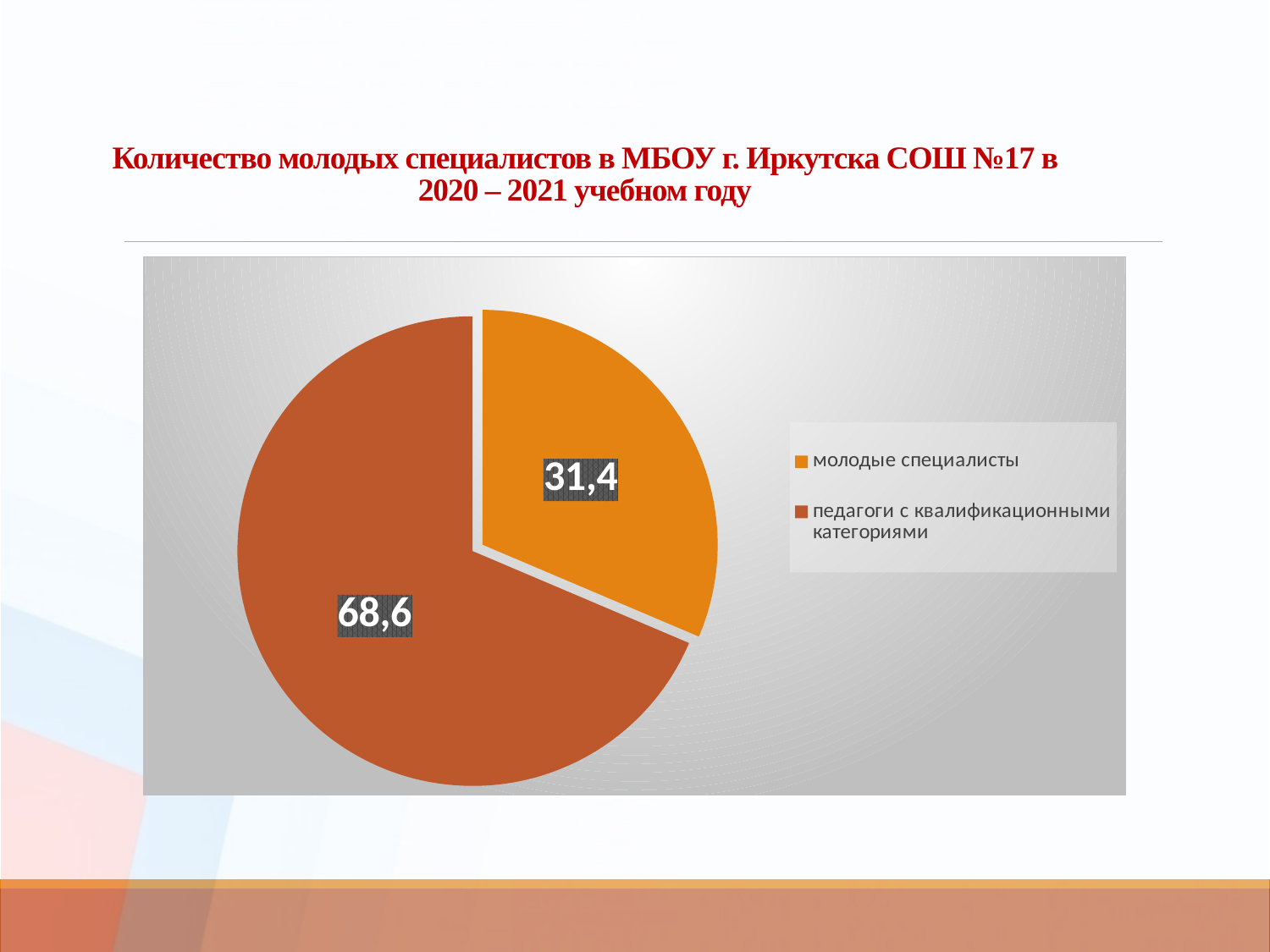
Which category has the smallest slice of the pie? молодые специалисты What is the value shown for "педагоги с квалификационными категориями"? 68,6 How many slices does the pie chart have? 2 What is the difference between the values for "педагоги с квалификационными категориями" and "молодые специалисты"? 37,2 What share of the pie does the "молодые специалисты" slice represent? 31,4% Which is larger: the value for "молодые специалисты" or the value for "педагоги с квалификационными категориями"? педагоги с квалификационными категориями What colour is the slice for "молодые специалисты"? Orange What is the value shown for "молодые специалисты"? 31,4 Which category has the largest slice of the pie? педагоги с квалификационными категориями What is the title of the slide above the chart? Количество молодых специалистов в МБОУ г. Иркутска СОШ №17 в 2020 – 2021 учебном году How many entries does the legend list? 2 What kind of chart is shown on the slide? Pie chart